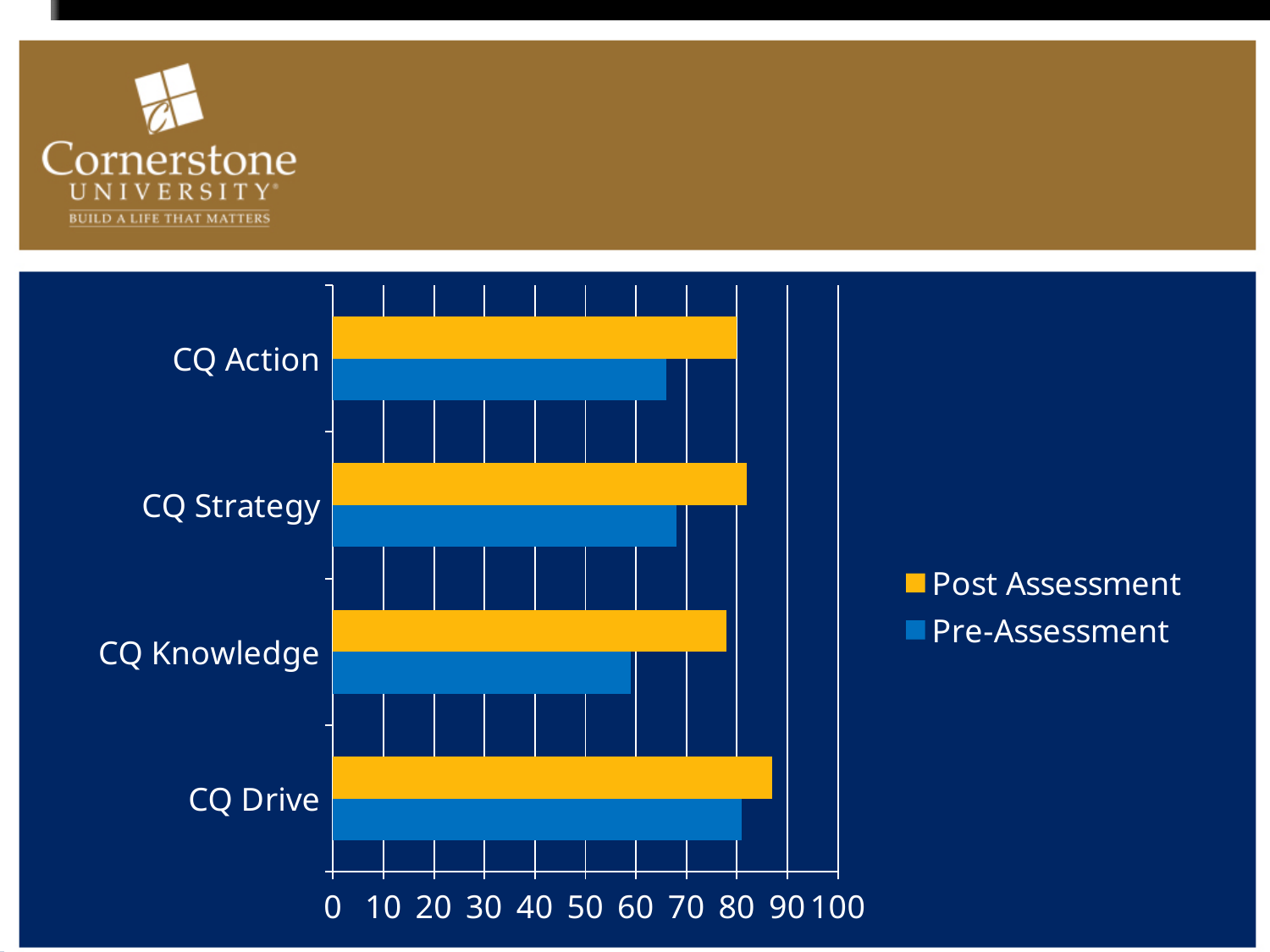
Is the Pre-Assessment value for CQ Knowledge greater or less than 70? less Which category has the highest Post Assessment value? CQ Drive What kind of chart is shown on the slide? bar chart How many series does the legend list? 2 For CQ Knowledge, which is larger: the Post Assessment value or the Pre-Assessment value? Post Assessment What colour represents the Post Assessment series in the legend? yellow Is the Pre-Assessment value for CQ Drive greater or less than 70? greater Is the Pre-Assessment value for CQ Action greater or less than 70? less Which category has the highest Pre-Assessment value? CQ Drive How many categories are shown on the chart? 4 Which category has the lowest Pre-Assessment value? CQ Knowledge